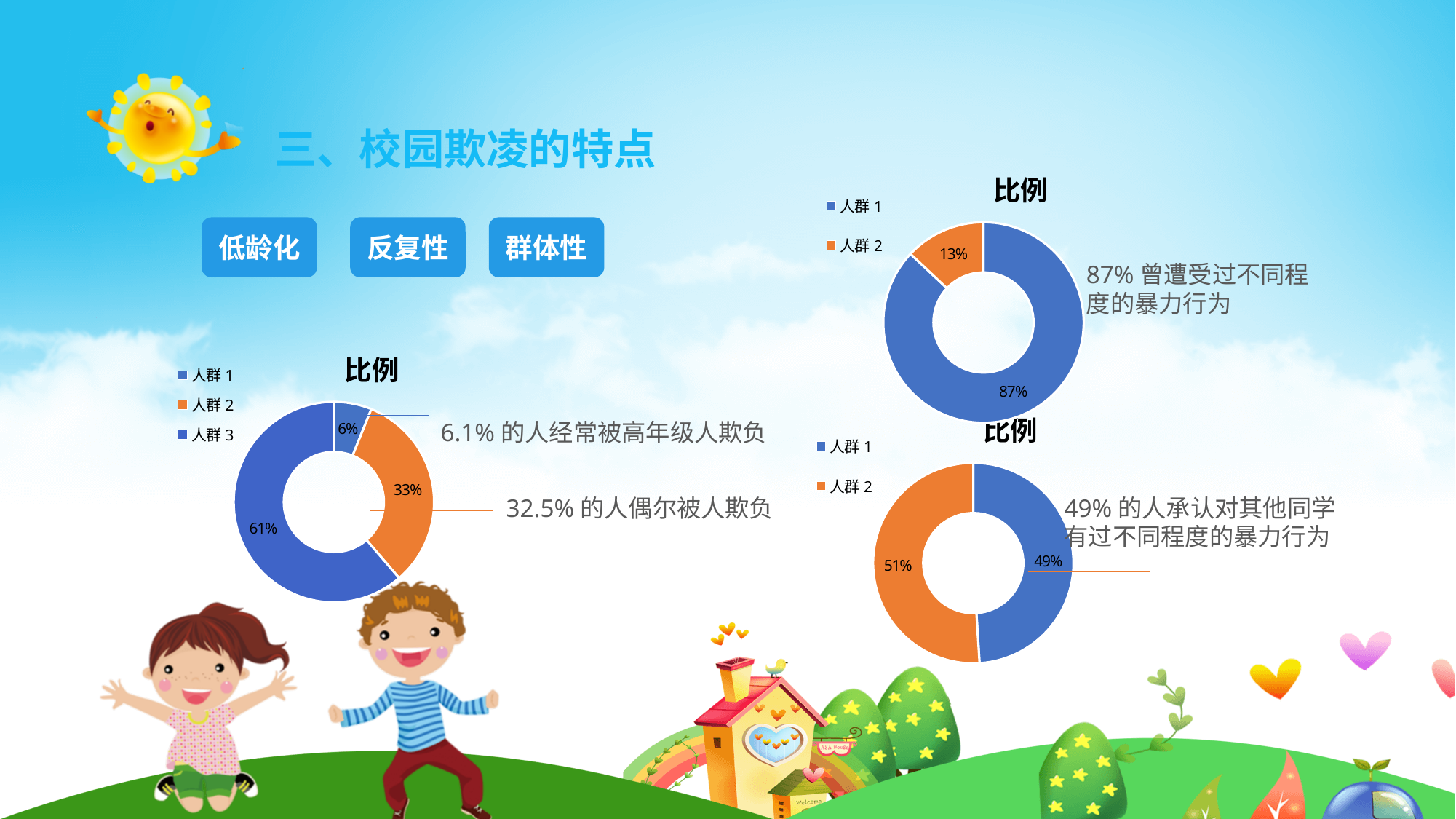
In the bottom-right chart, what is the value for 人群 2? 51% In the top-right chart, what is the value for 人群 2? 13% How many entries does the legend list for the chart on the left side of the slide? 3 In the chart on the left side of the slide, what is the smallest slice value? 6% In the chart on the left side of the slide, what is the value for 人群 2? 33% What is the title shown above each of the three charts on the slide? 比例 In the chart on the left side of the slide, what is the largest slice value? 61% In the top-right chart, what is the value for 人群 1? 87% In the bottom-right chart, what is the difference between 人群 2 and 人群 1? 2% What kind of chart is the chart on the left side of the slide? doughnut chart In the top-right chart, what is the difference between 人群 1 and 人群 2? 74% In the bottom-right chart, which is larger, 人群 1 or 人群 2? 人群 2